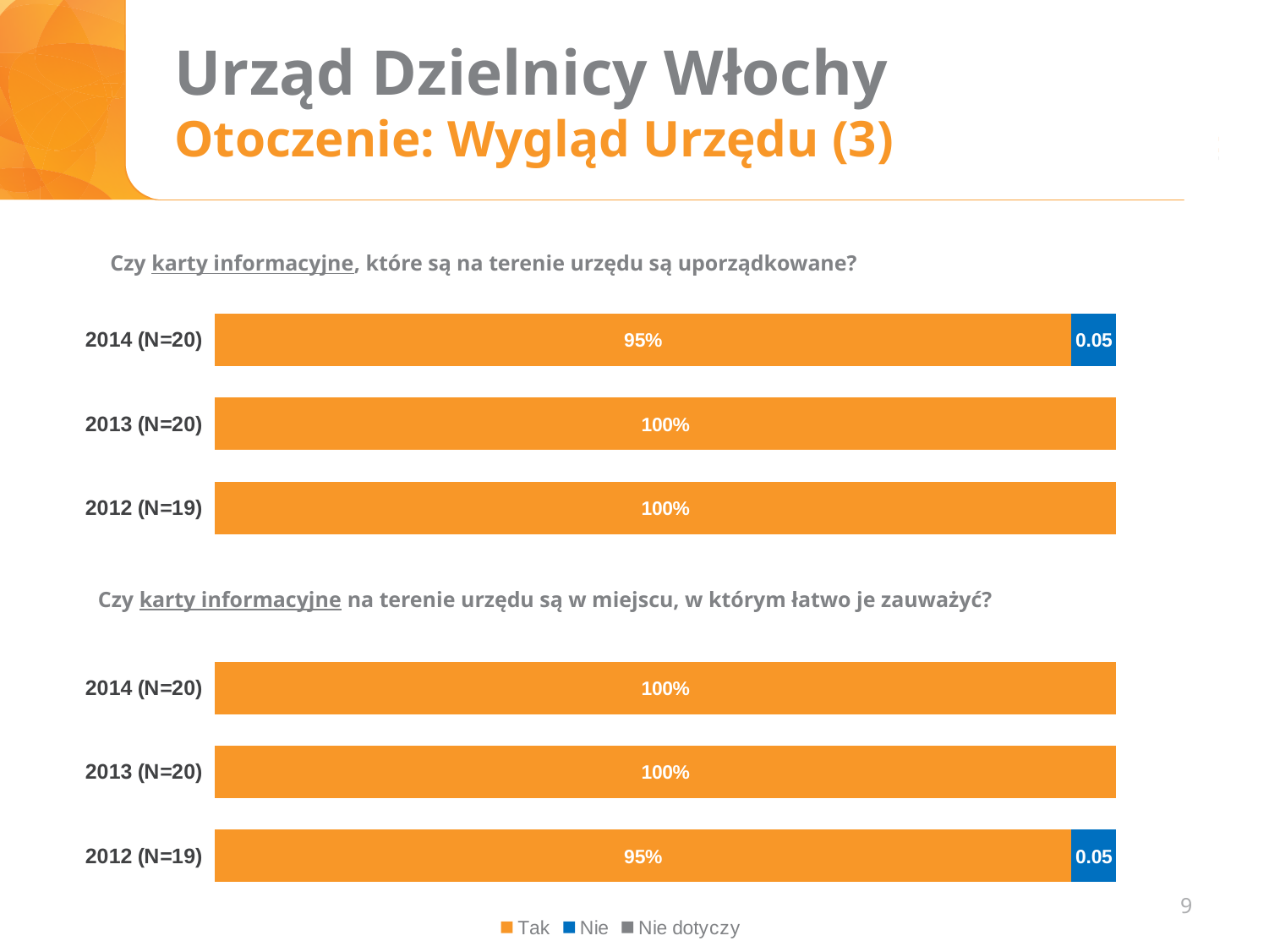
In the bottom chart, what is the 'Tak' value for 2012 (N=19)? 95% In the bottom chart, is the 'Tak' value for 2014 (N=20) larger or smaller than for 2012 (N=19)? larger In the top chart, what is the 'Nie' value shown for 2014 (N=20)? 0.05 In the top chart, what is the 'Tak' value for 2014 (N=20)? 95% In the bottom chart, what is the 'Tak' value for 2013 (N=20)? 100% How many year categories does the top chart show? 3 In the bottom chart, which year has the lowest 'Tak' value? 2012 (N=19) In the top chart, what is the 'Tak' value for 2012 (N=19)? 100% In the top chart, what is the difference between the 'Tak' values for 2013 (N=20) and 2014 (N=20)? 5% How many series does the legend at the bottom of the slide list? 3 In the top chart, which year has the lowest 'Tak' value? 2014 (N=20) What type of chart is the bottom chart? Bar chart